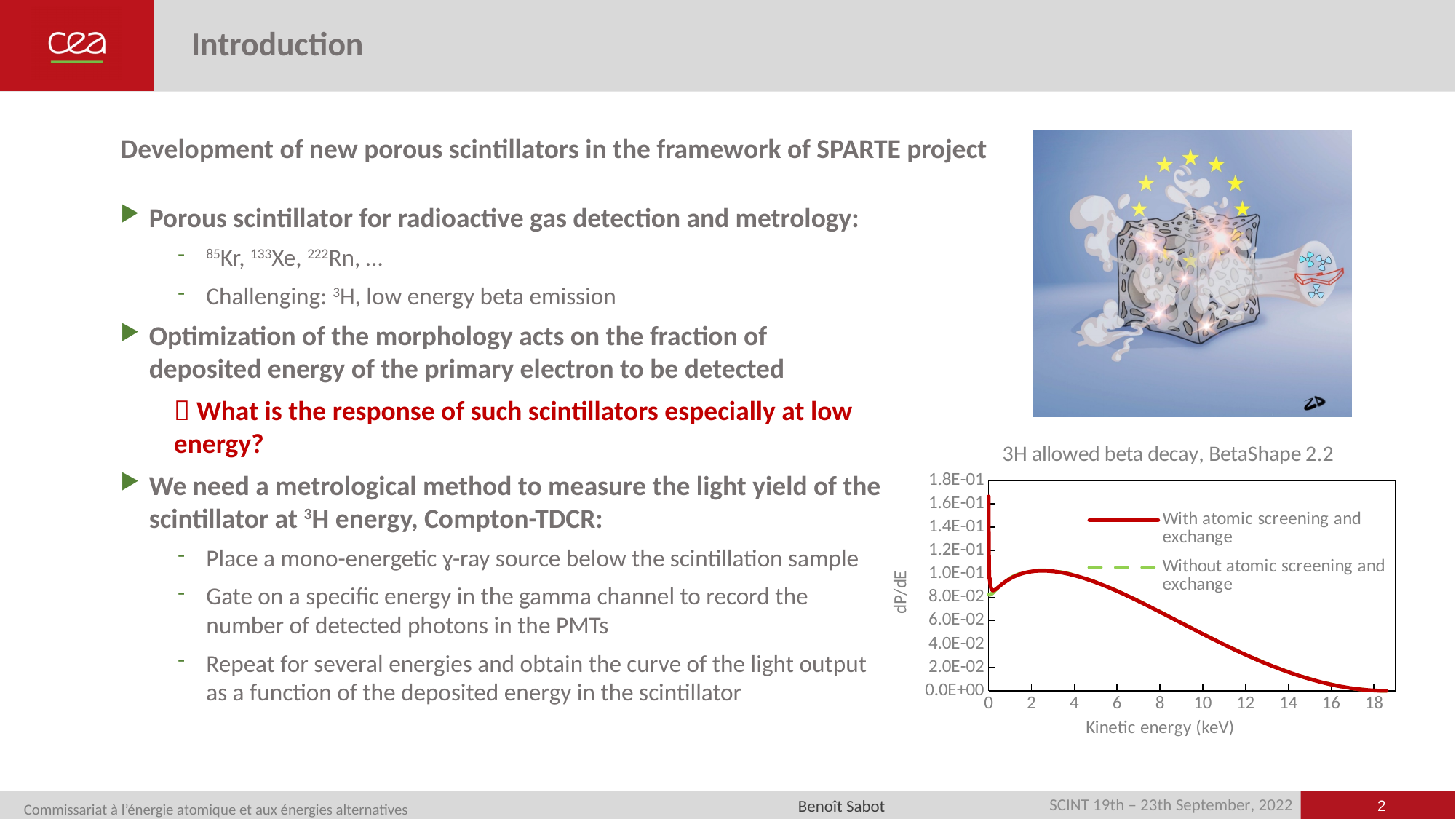
Is the value of the 'With atomic screening and exchange' curve at 14 keV greater or less than 6.0E-02? less What kind of chart is shown on the slide? line chart Is the value of the 'With atomic screening and exchange' curve at 8 keV greater or less than 1.0E-01? less Between 4 keV and 18 keV, does the 'With atomic screening and exchange' curve rise or fall as kinetic energy increases? fall What is the label of the x axis of the chart? Kinetic energy (keV) Is the value of the 'With atomic screening and exchange' curve at 12 keV greater or less than 6.0E-02? less How many series does the chart legend list? 2 What is the label of the y axis of the chart? dP/dE What is the title of the chart? 3H allowed beta decay, BetaShape 2.2